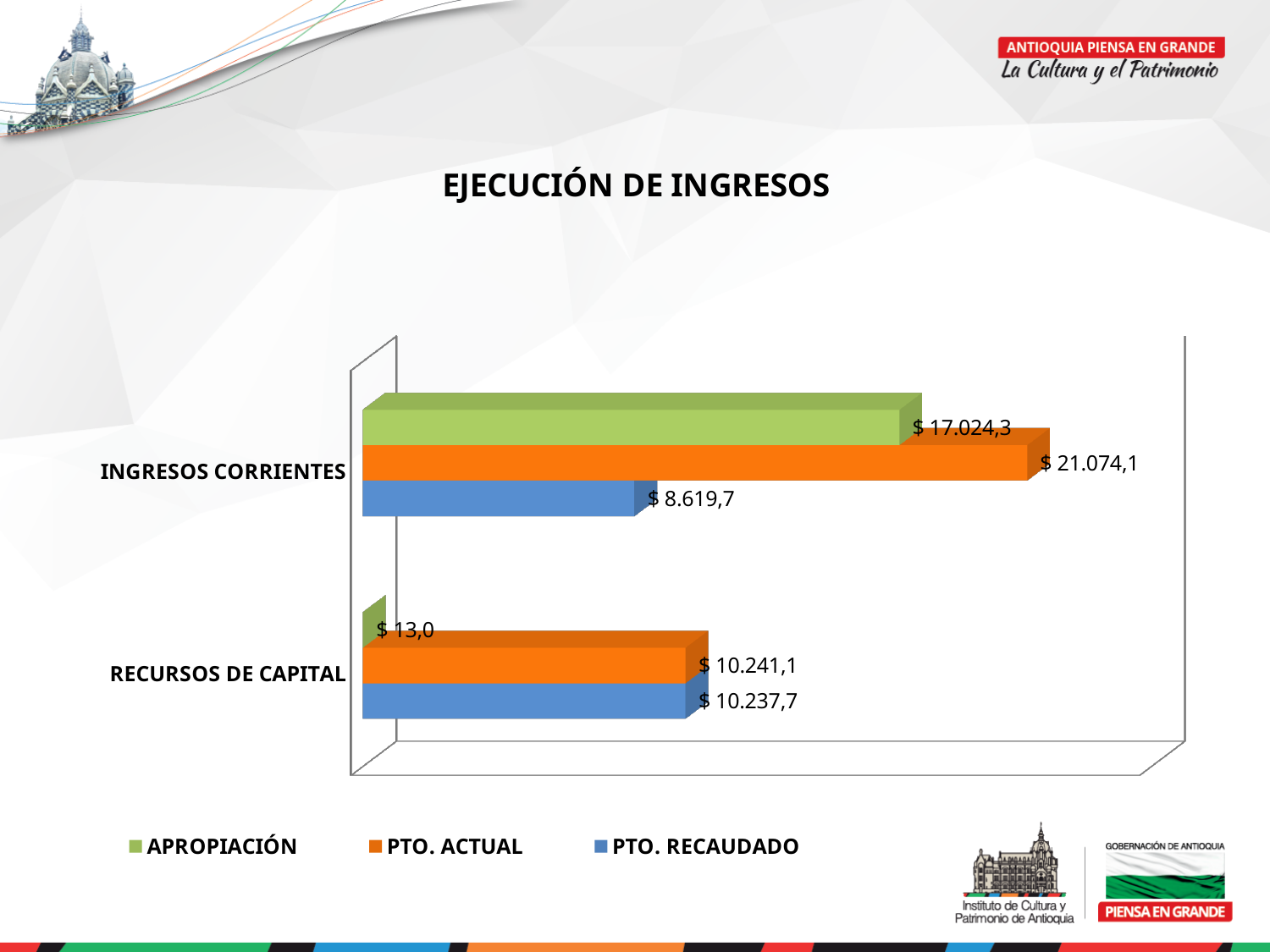
Which is larger for INGRESOS CORRIENTES: APROPIACIÓN or PTO. RECAUDADO? APROPIACIÓN What is the difference between PTO. ACTUAL and APROPIACIÓN for INGRESOS CORRIENTES? $ 4.049,8 What is the PTO. RECAUDADO value for RECURSOS DE CAPITAL? $ 10.237,7 How many series does the legend list? 3 What kind of chart is shown on the slide? Bar chart What is the APROPIACIÓN value for RECURSOS DE CAPITAL? $ 13,0 What is the PTO. ACTUAL value for INGRESOS CORRIENTES? $ 21.074,1 Which series has the highest value for INGRESOS CORRIENTES? PTO. ACTUAL What is the PTO. RECAUDADO value for INGRESOS CORRIENTES? $ 8.619,7 What is the difference between PTO. ACTUAL and PTO. RECAUDADO for RECURSOS DE CAPITAL? $ 3,4 What is the APROPIACIÓN value for INGRESOS CORRIENTES? $ 17.024,3 Which series has the lowest value for RECURSOS DE CAPITAL? APROPIACIÓN